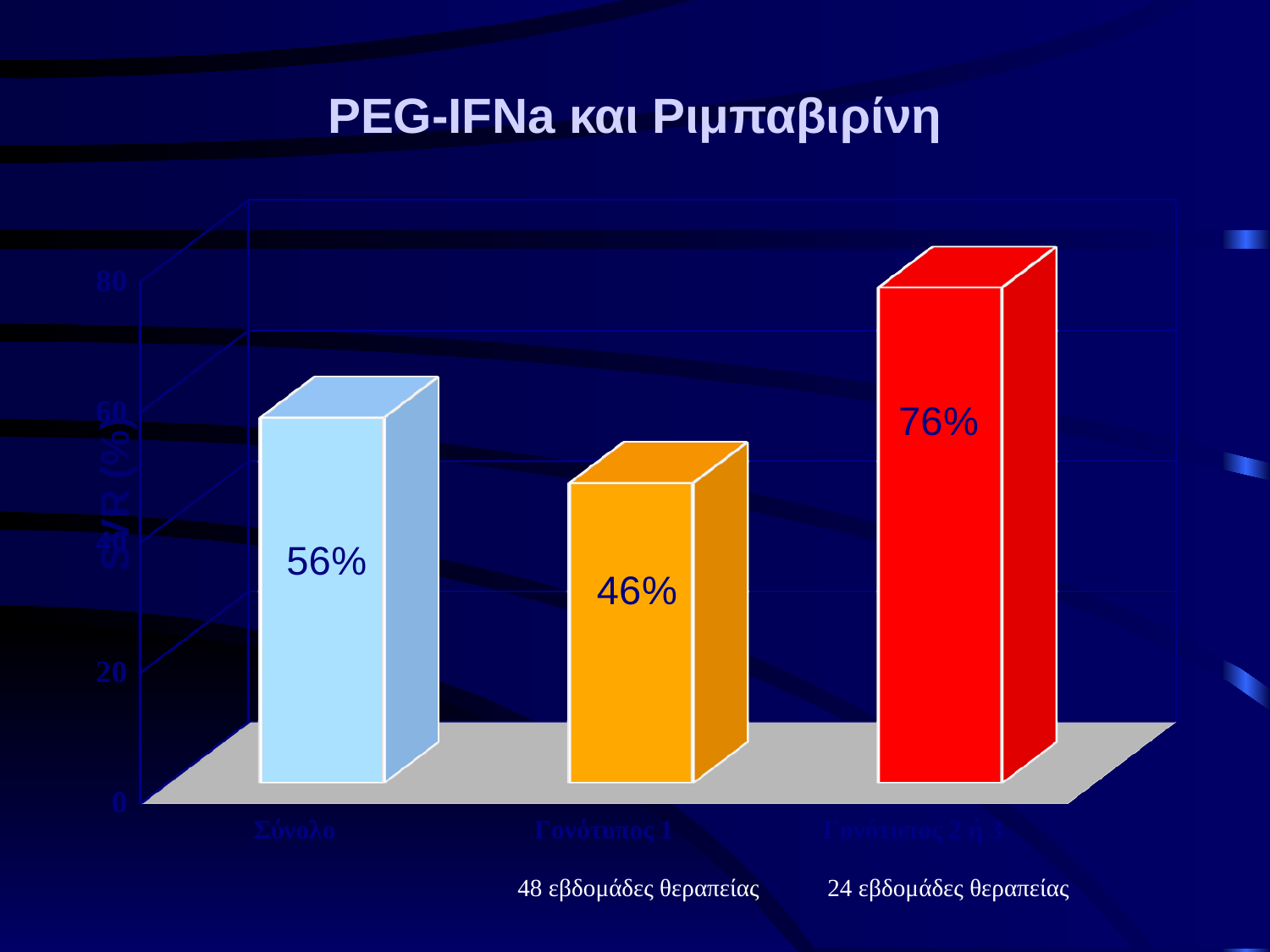
What is the difference between the SVR values for Γονότυπος 2 ή 3 and Γονότυπος 1? 30% What is the title of the slide? PEG-IFNa και Ριμπαβιρίνη Which category has the lowest SVR value? Γονότυπος 1 Which category has the highest SVR value? Γονότυπος 2 ή 3 What kind of chart is shown on the slide? bar chart What is the difference between the SVR values for Σύνολο and Γονότυπος 1? 10% What is the SVR value for Γονότυπος 2 ή 3? 76% How many categories are shown in the chart? 3 What is the SVR value for Σύνολο? 56% Is the value for Γονότυπος 2 ή 3 greater or less than 60? greater Which is larger, the SVR value for Σύνολο or for Γονότυπος 1? Σύνολο What is the SVR value for Γονότυπος 1? 46%